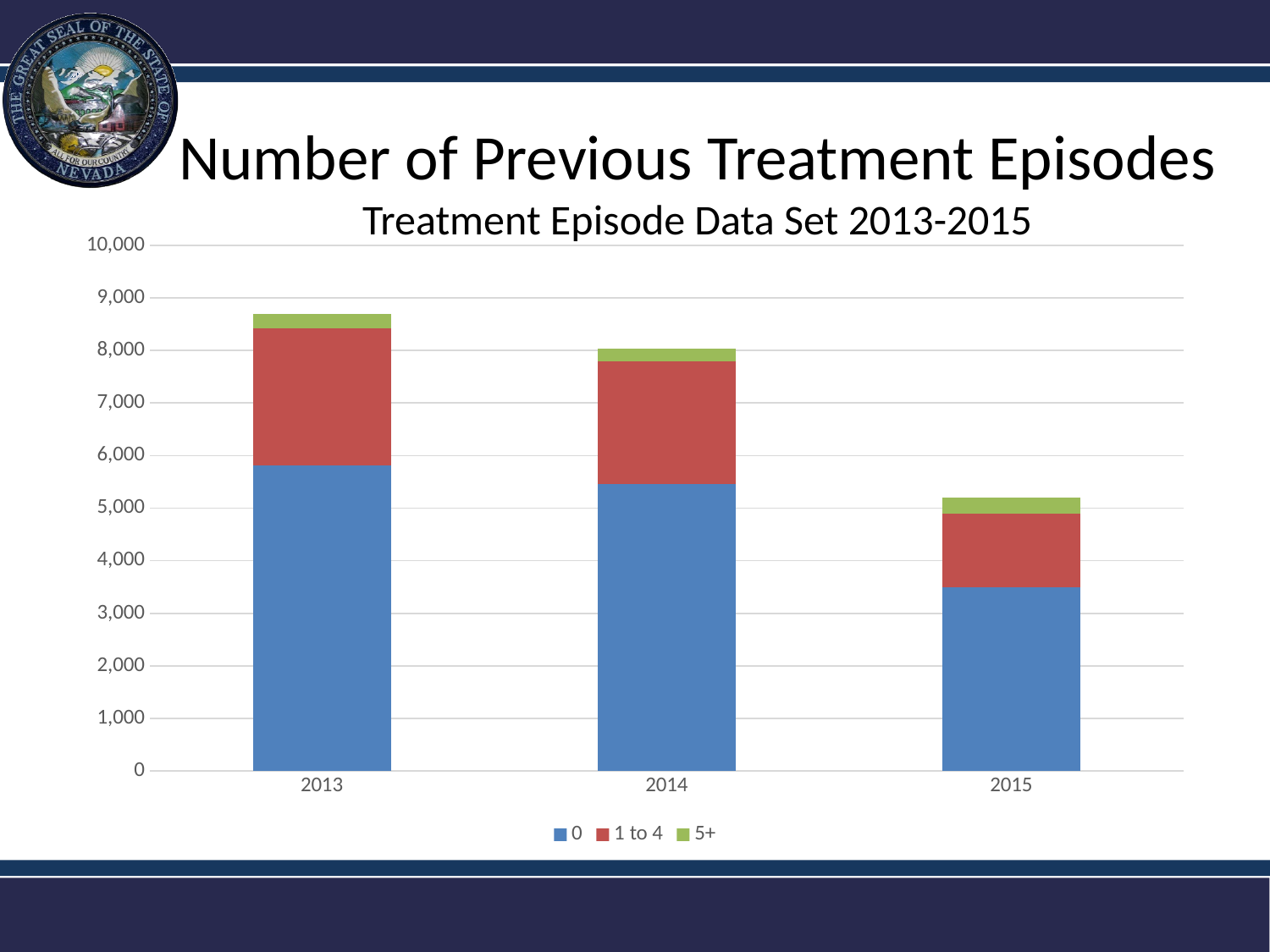
Is the value for the '0' series in 2013 greater or less than 5,000? greater Which is larger, the '0' series value in 2014 or the '0' series value in 2015? 2014 Which year has the shortest stacked bar? 2015 How many series does the legend list? 3 Do the total bar heights rise or fall from 2013 to 2015? fall Is the total stacked bar for 2014 greater or less than 9,000? less Is the value for the '0' series in 2015 greater or less than 4,000? less What is the subtitle of the chart? Treatment Episode Data Set 2013-2015 Which year has the tallest stacked bar? 2013 How many years are shown on the x axis? 3 What kind of chart is shown on the slide? stacked bar chart Which series is shown in green in the legend? 5+